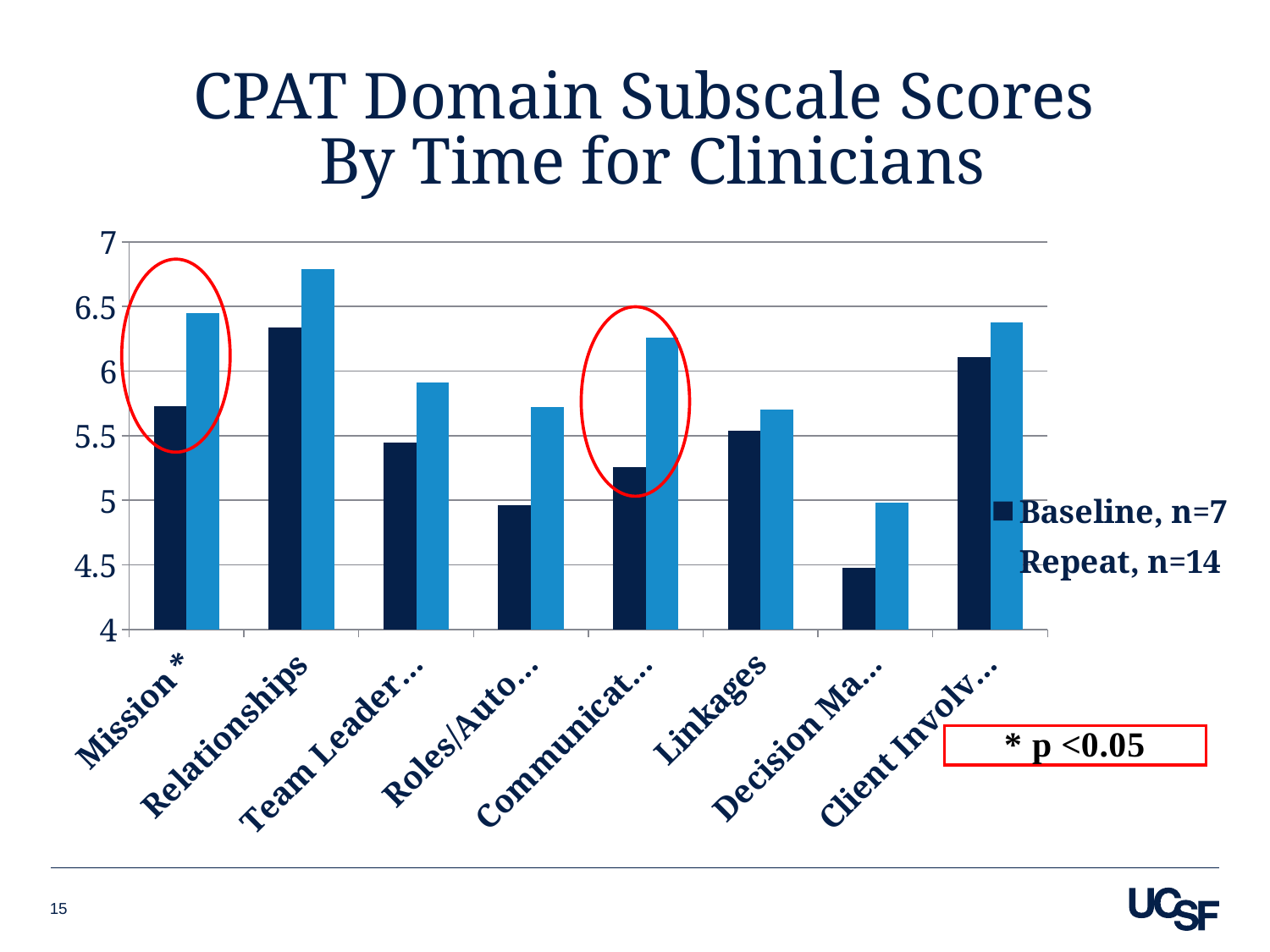
For Mission, which is larger: the Baseline, n=7 value or the Repeat, n=14 value? Repeat, n=14 What kind of chart is shown on the slide? bar chart Which category has the lowest Baseline, n=7 bar? Decision Ma… How many series does the legend list? 2 Which is larger: the Baseline, n=7 value for Relationships or the Baseline, n=7 value for Linkages? Relationships Is the Repeat, n=14 value for Relationships greater or less than 6.5? greater Is the Baseline, n=7 value for Mission greater or less than 5.5? greater How many domain categories are shown on the x axis? 8 What is the title of the chart? CPAT Domain Subscale Scores By Time for Clinicians Which category has the highest Repeat, n=14 bar? Relationships Is the Repeat, n=14 value for Linkages greater or less than 6? less